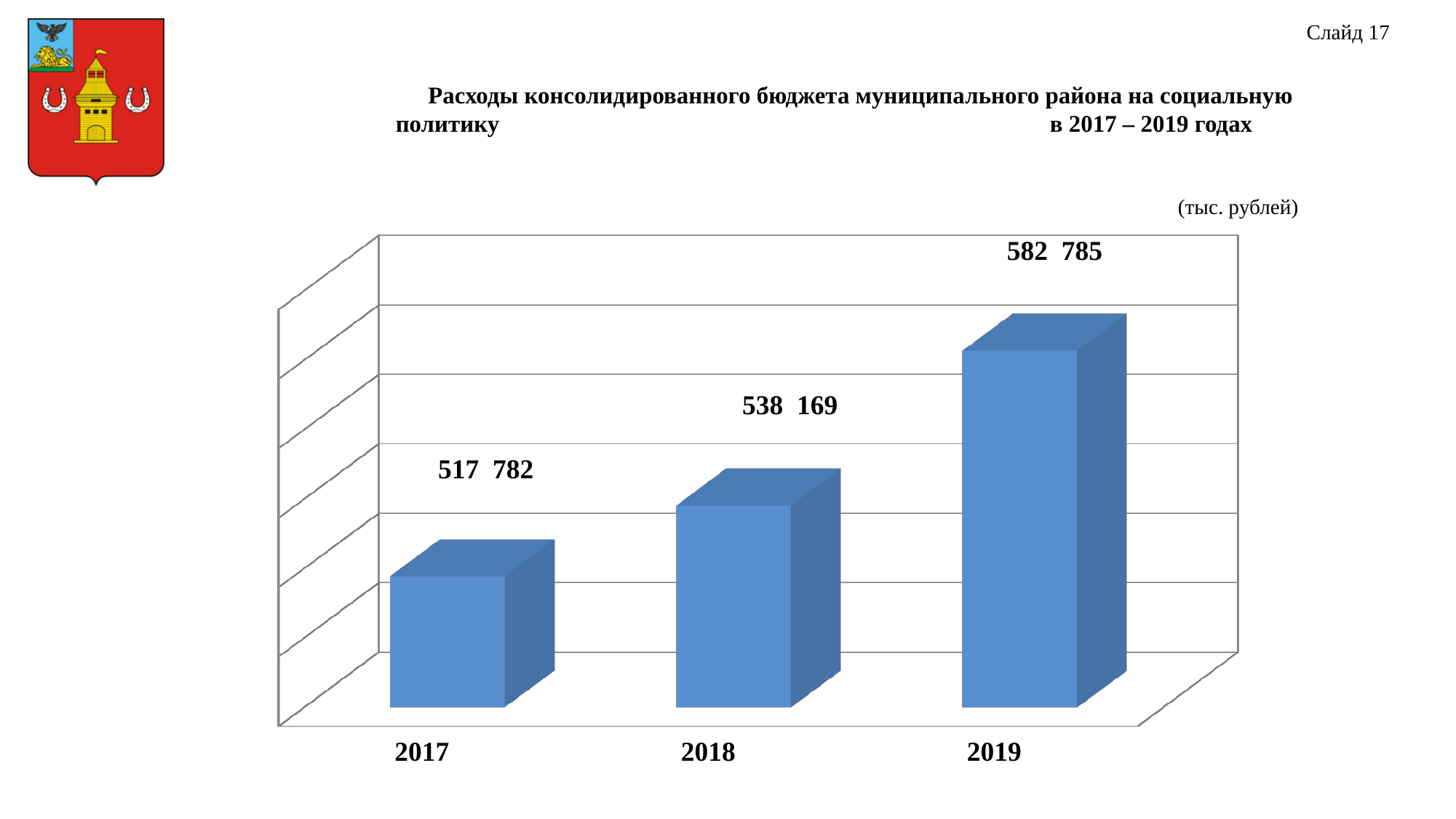
Do the values rise or fall from 2017 to 2019? Rise What kind of chart is shown on the slide? Bar chart Which is larger, the value for 2018 or the value for 2017? 2018 What is the difference between the values for 2019 and 2018? 44 616 What is the value for 2017? 517 782 Which year has the lowest value? 2017 How many years are shown on the chart? 3 What is the difference between the values for 2018 and 2017? 20 387 What is the difference between the values for 2019 and 2017? 65 003 Which year has the highest value? 2019 What is the value for 2018? 538 169 What is the value for 2019? 582 785